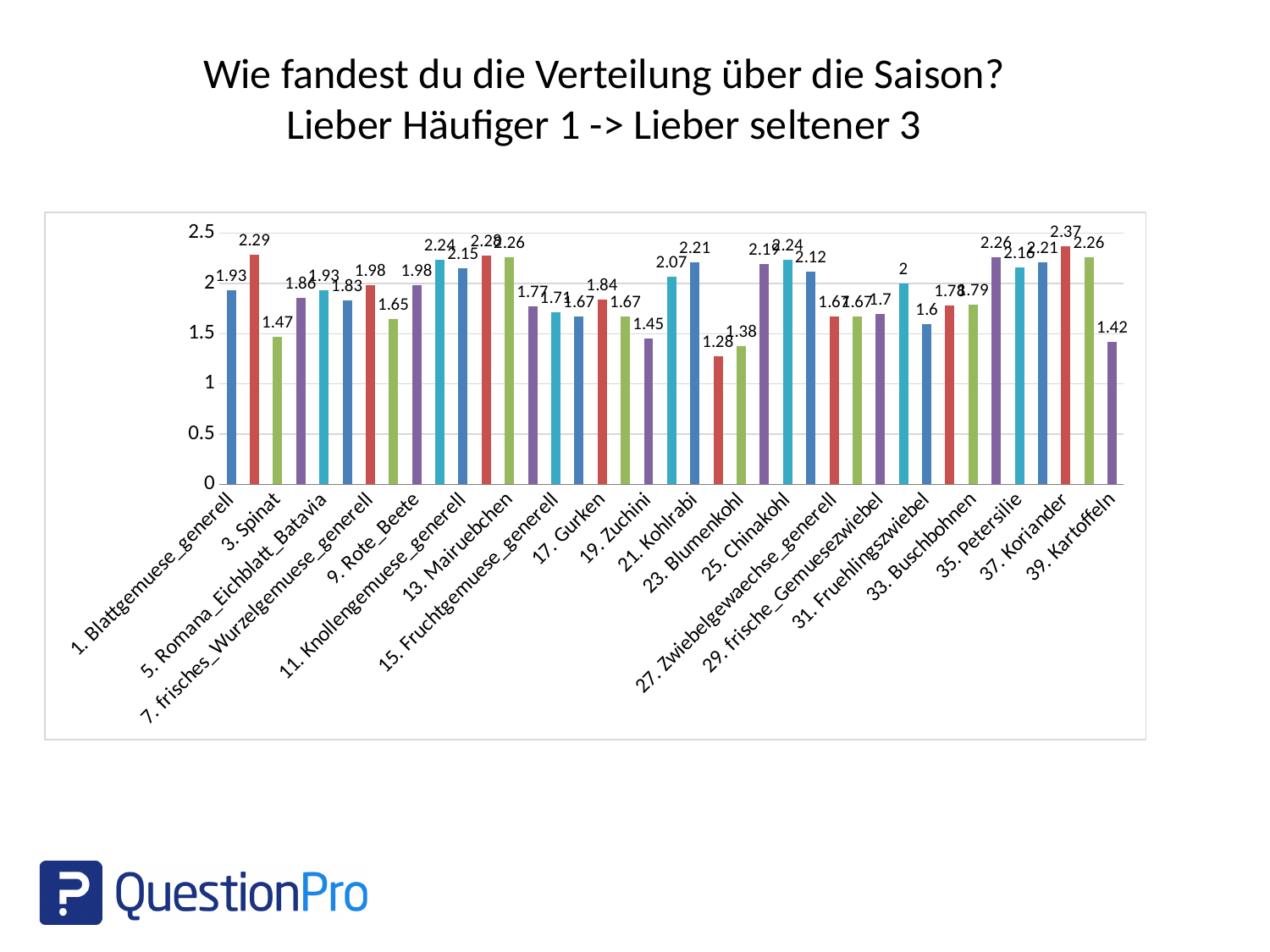
What is the difference between the values for 37. Koriander and 39. Kartoffeln? 0.95 Is the value for 21. Kohlrabi greater or less than 2? greater What kind of chart is shown on the slide? bar chart What is the value for 19. Zuchini? 1.45 How many bars are plotted in the chart? 39 What is the value for 39. Kartoffeln? 1.42 What is the value for 13. Mairuebchen? 2.26 Which is larger, the value for 3. Spinat or the value for 9. Rote_Beete? 9. Rote_Beete What is the lowest value shown in the chart? 1.28 Which labelled category has the highest value? 37. Koriander What is the value for 3. Spinat? 1.47 What is the value for 37. Koriander? 2.37